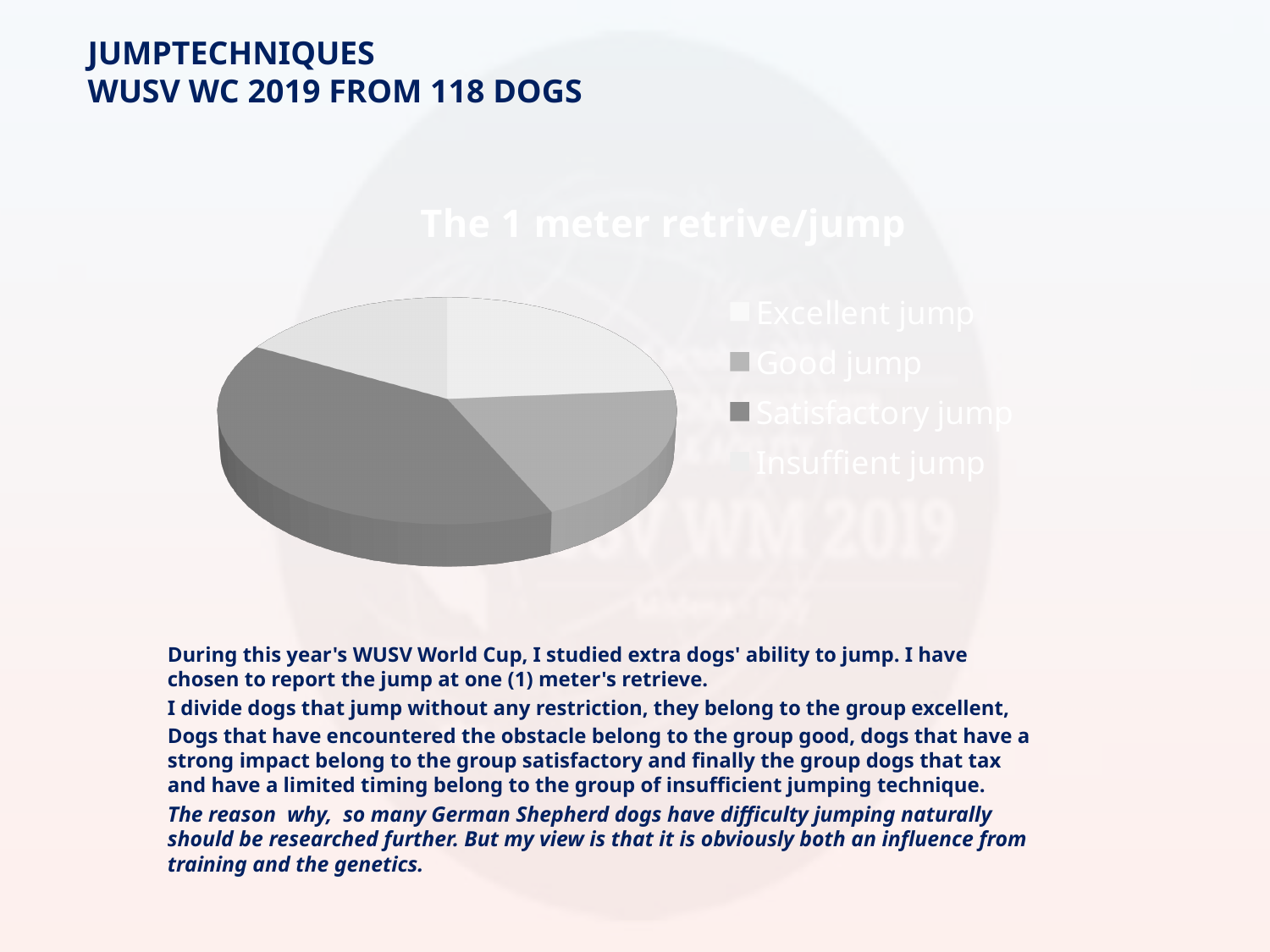
Which legend entry is listed first in the chart's legend? Excellent jump What is the title of the chart? The 1 meter retrive/jump Which slice is larger, Satisfactory jump or Excellent jump? Satisfactory jump Which slice is larger, Satisfactory jump or Good jump? Satisfactory jump What kind of chart is shown on the slide? pie chart How many categories does the chart's legend list? 4 Which category has the largest slice of the pie? Satisfactory jump